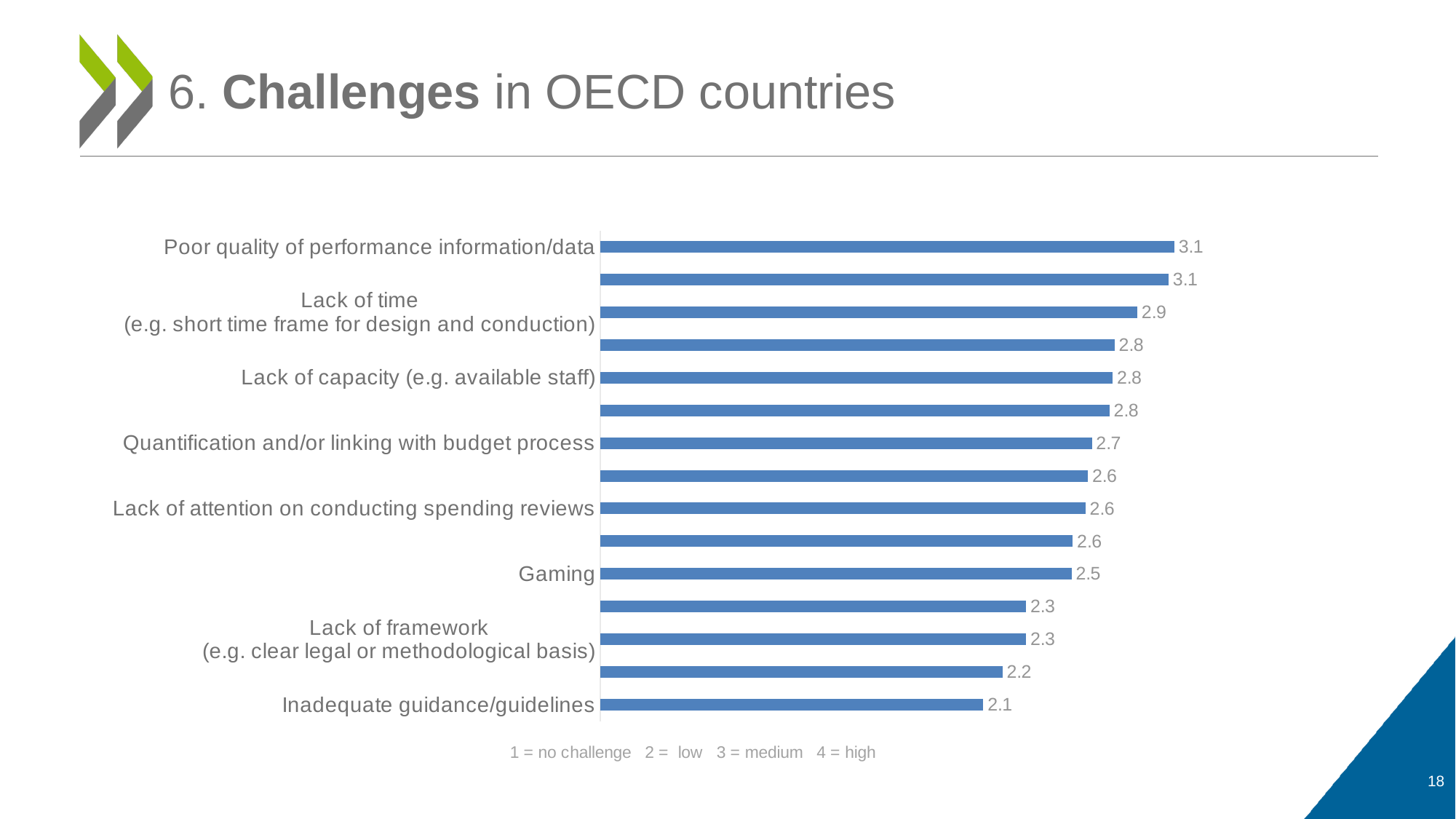
Which labelled challenge has the lowest value? Inadequate guidance/guidelines Do the bar values increase or decrease from the top of the chart to the bottom? Decrease What kind of chart is shown on the slide? Bar chart What is the value for Lack of capacity (e.g. available staff)? 2.8 What is the value for Poor quality of performance information/data? 3.1 How many bars are plotted in the chart? 15 What is the value for Lack of time (e.g. short time frame for design and conduction)? 2.9 According to the note below the chart, what does a score of 4 mean? high What is the value for Gaming? 2.5 What is the difference between the values for Poor quality of performance information/data and Inadequate guidance/guidelines? 1.0 What is the value for Inadequate guidance/guidelines? 2.1 Which has a larger value, Quantification and/or linking with budget process or Lack of framework (e.g. clear legal or methodological basis)? Quantification and/or linking with budget process